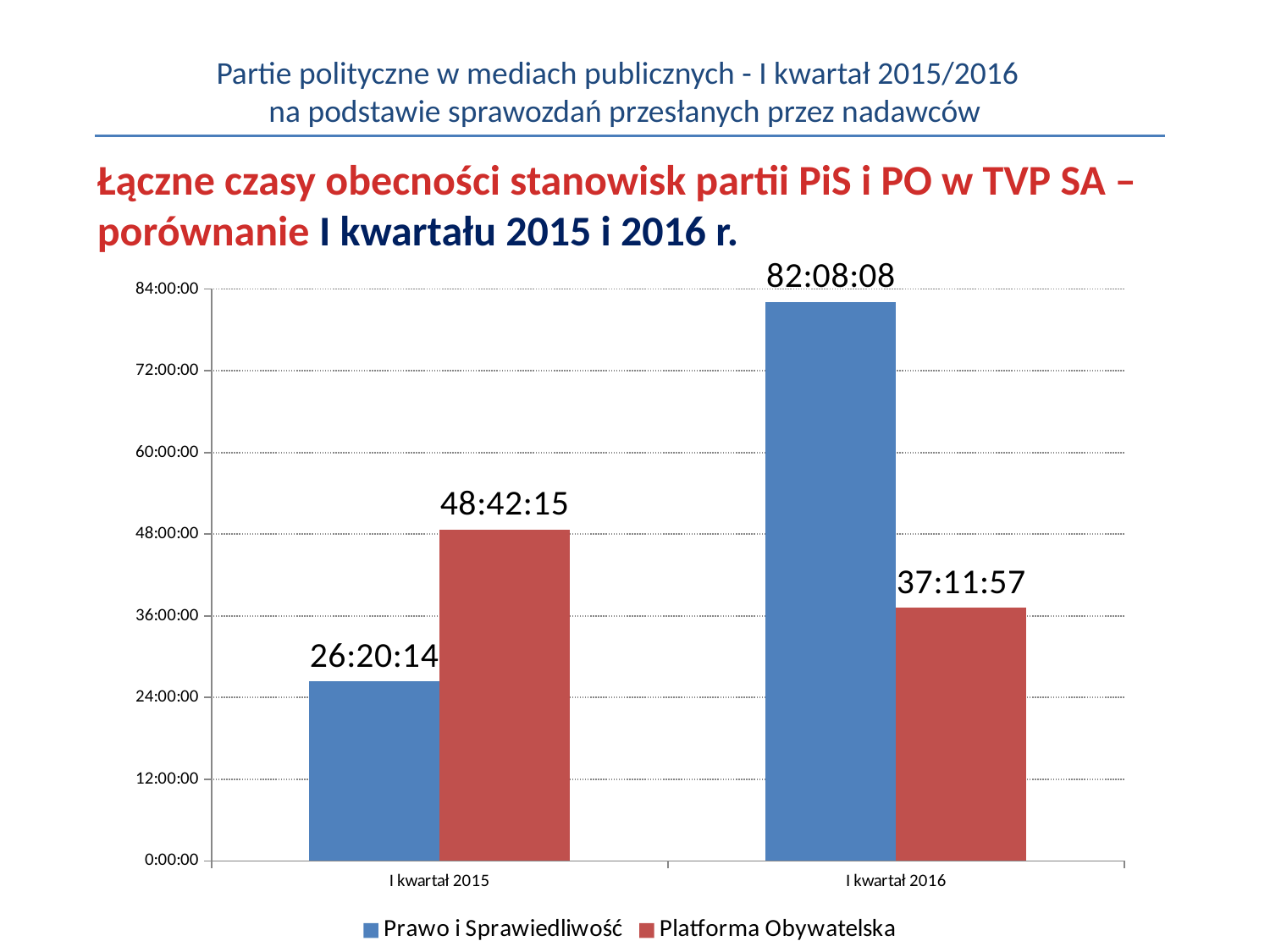
What is the value for Platforma Obywatelska in I kwartał 2015? 48:42:15 How many categories are shown on the x axis? 2 What is the value for Platforma Obywatelska in I kwartał 2016? 37:11:57 How many series does the legend list? 2 Which party has the larger value in I kwartał 2016? Prawo i Sprawiedliwość What kind of chart is shown on the slide? Bar chart Which bar has the lowest value on the chart? Prawo i Sprawiedliwość, I kwartał 2015 What is the value for Prawo i Sprawiedliwość in I kwartał 2015? 26:20:14 What is the difference between Prawo i Sprawiedliwość and Platforma Obywatelska in I kwartał 2016? 44:56:11 Which party has the larger value in I kwartał 2015? Platforma Obywatelska What is the value for Prawo i Sprawiedliwość in I kwartał 2016? 82:08:08 Which bar has the highest value on the chart? Prawo i Sprawiedliwość, I kwartał 2016